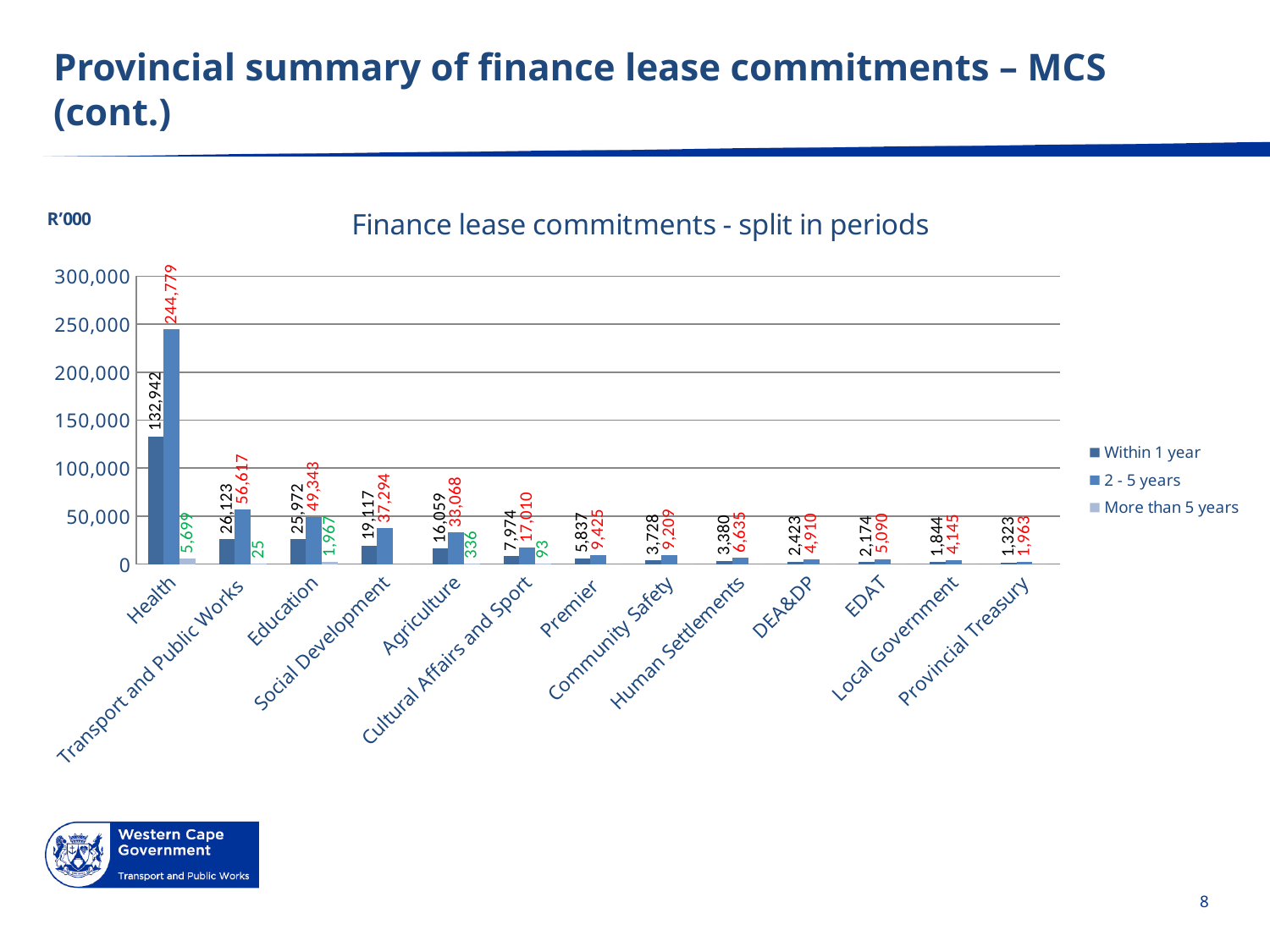
What type of chart is shown? Bar chart What is the '2 - 5 years' value for Cultural Affairs and Sport? 17,010 What is the '2 - 5 years' value for Transport and Public Works? 56,617 What is the 'Within 1 year' value for Health? 132,942 What is the difference between the '2 - 5 years' and 'Within 1 year' values for Health? 111,837 Which department has the highest '2 - 5 years' value? Health How many series does the legend list? 3 Is the '2 - 5 years' value for Health greater or less than 200,000? greater How many departments are shown on the x axis? 13 Which is larger: the '2 - 5 years' value for Premier or for Community Safety? Premier What is the 'More than 5 years' value for Education? 1,967 Which department has the lowest 'Within 1 year' value? Provincial Treasury